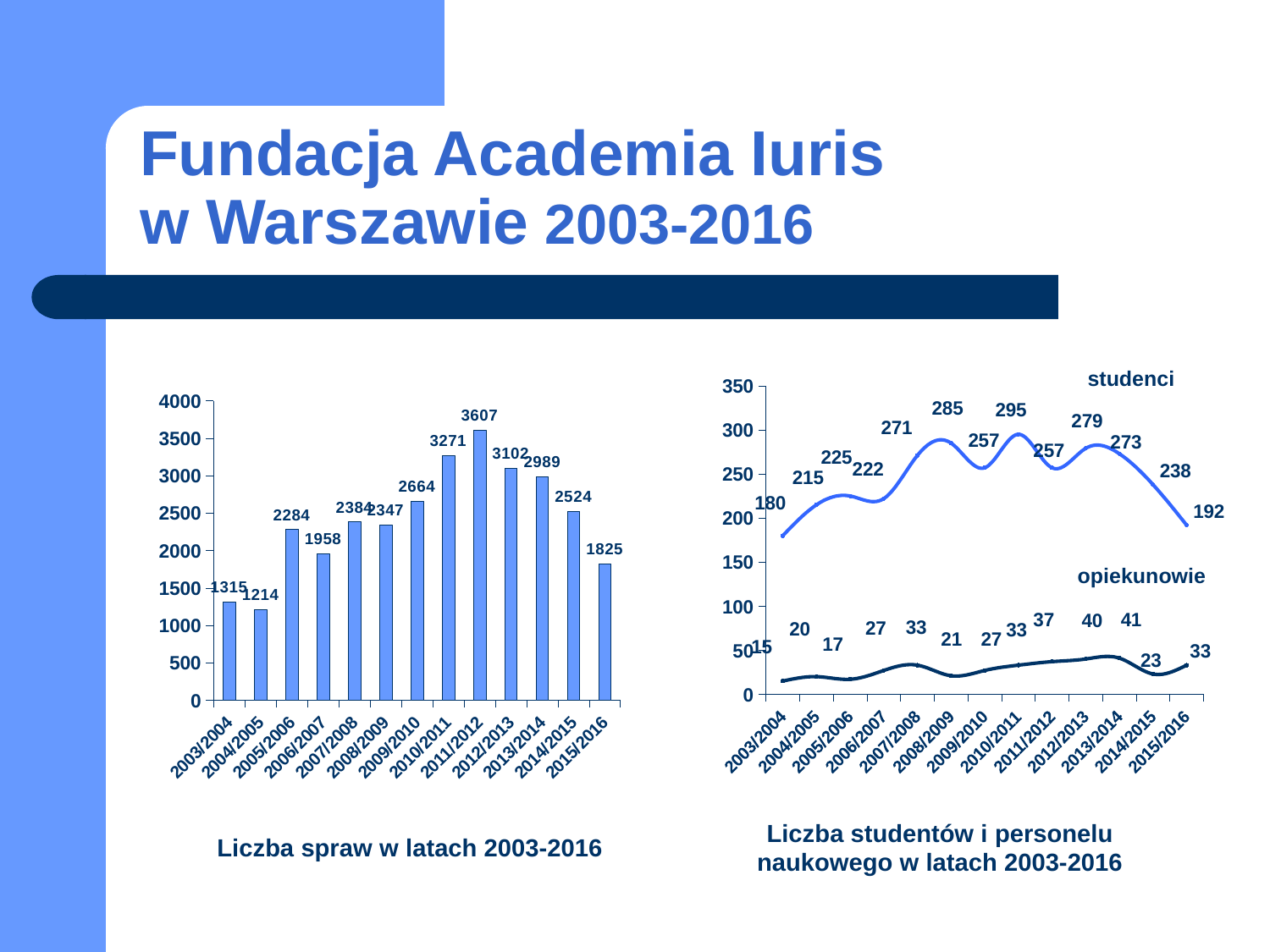
How many series are plotted in the right chart (Liczba studentów i personelu naukowego)? 2 In the left chart (Liczba spraw w latach 2003-2016), what is the difference between the values for 2011/2012 and 2015/2016? 1782 In the right chart (Liczba studentów i personelu naukowego), what is the value of opiekunowie for 2013/2014? 41 In the right chart (Liczba studentów i personelu naukowego), what is the difference between studenci and opiekunowie in 2015/2016? 159 In the left chart (Liczba spraw w latach 2003-2016), which is larger, the value for 2005/2006 or the value for 2006/2007? 2005/2006 In the right chart (Liczba studentów i personelu naukowego), what is the value of studenci for 2010/2011? 295 What kind of chart is the left chart (Liczba spraw w latach 2003-2016)? bar chart In the right chart (Liczba studentów i personelu naukowego), which year has the highest value for studenci? 2010/2011 How many bars are shown in the left chart (Liczba spraw w latach 2003-2016)? 13 In the right chart (Liczba studentów i personelu naukowego), does the studenci line rise or fall from 2013/2014 to 2015/2016? fall In the left chart (Liczba spraw w latach 2003-2016), what is the value for 2011/2012? 3607 In the left chart (Liczba spraw w latach 2003-2016), which year has the lowest number of cases? 2004/2005